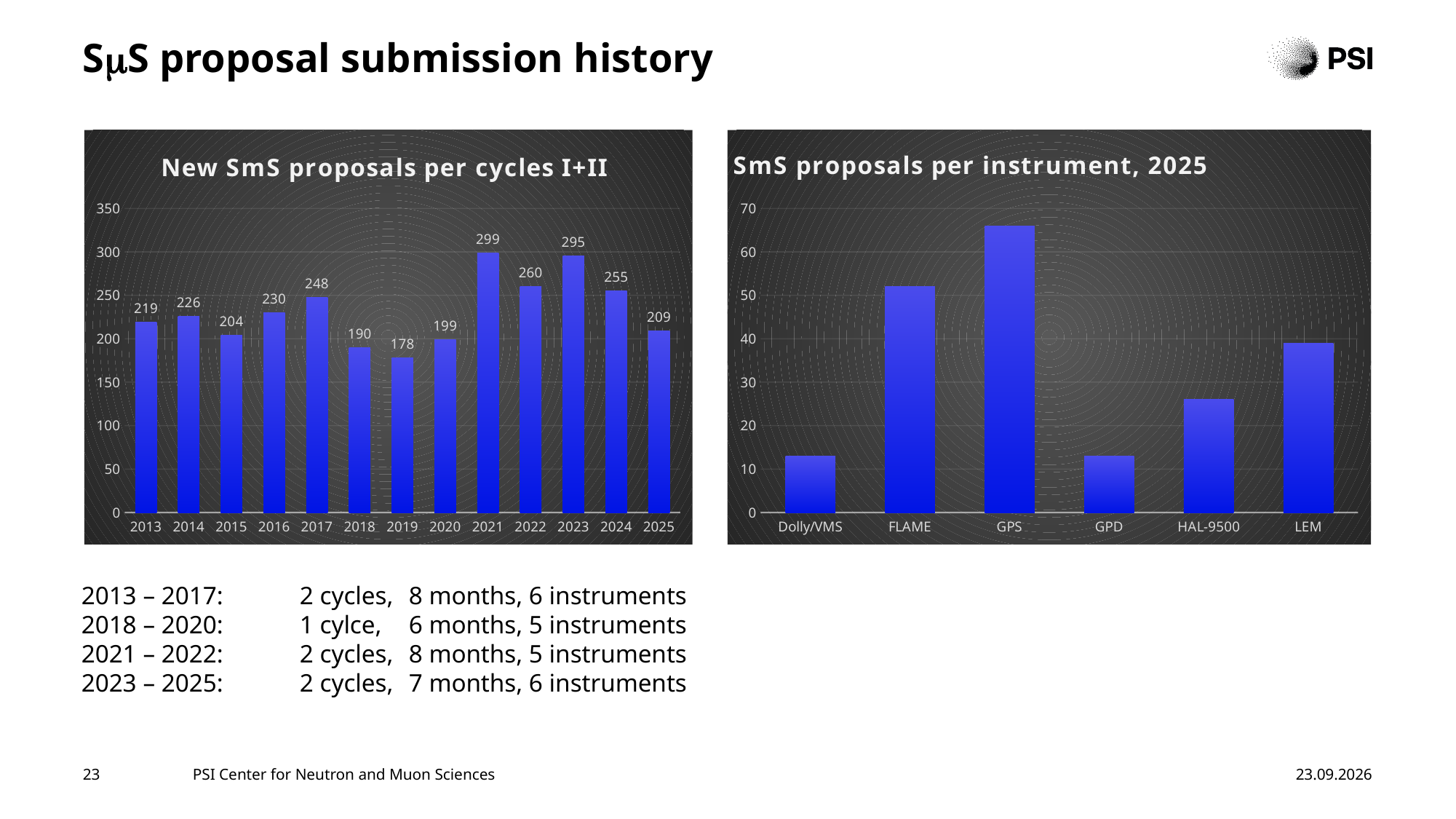
In the 'New SmS proposals per cycles I+II' chart, which year has the lowest value? 2019 In the 'SmS proposals per instrument, 2025' chart, is the value for HAL-9500 greater or less than 30? less In the 'New SmS proposals per cycles I+II' chart, what is the value for 2019? 178 What kind of chart is the 'SmS proposals per instrument, 2025' chart? bar chart How many years are shown in the 'New SmS proposals per cycles I+II' chart? 13 In the 'New SmS proposals per cycles I+II' chart, which year has the highest value? 2021 In the 'New SmS proposals per cycles I+II' chart, which is larger, the value for 2016 or the value for 2025? 2016 In the 'New SmS proposals per cycles I+II' chart, what is the difference between the values for 2023 and 2024? 40 In the 'SmS proposals per instrument, 2025' chart, is the value for FLAME greater or less than 50? greater How many instruments are shown in the 'SmS proposals per instrument, 2025' chart? 6 In the 'New SmS proposals per cycles I+II' chart, what is the value for 2021? 299 In the 'SmS proposals per instrument, 2025' chart, which instrument has the highest value? GPS